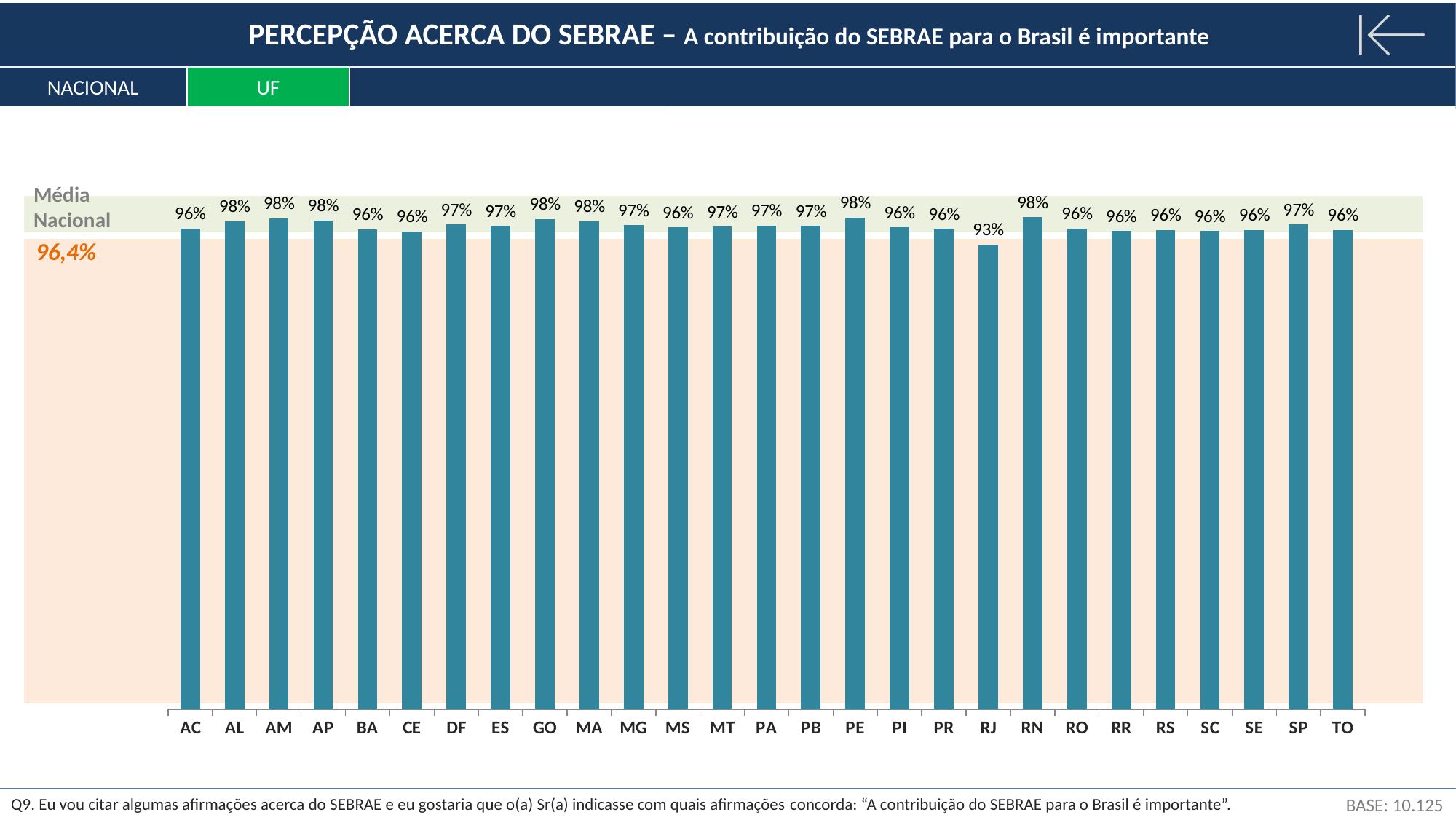
What is the difference between the values for AL and AC? 2% What kind of chart is shown? Bar chart Which UF has the lowest value? RJ Which is larger, the value for PE or the value for PI? PE What is the value for DF? 97% What is the difference between the values for RN and RJ? 5% How many UFs are shown on the x axis? 27 What is the value for GO? 98% Which is larger, the value for RJ or the value for SP? SP What is the value for RJ? 93% What is the value for BA? 96% What is the Média Nacional value shown on the chart? 96,4%